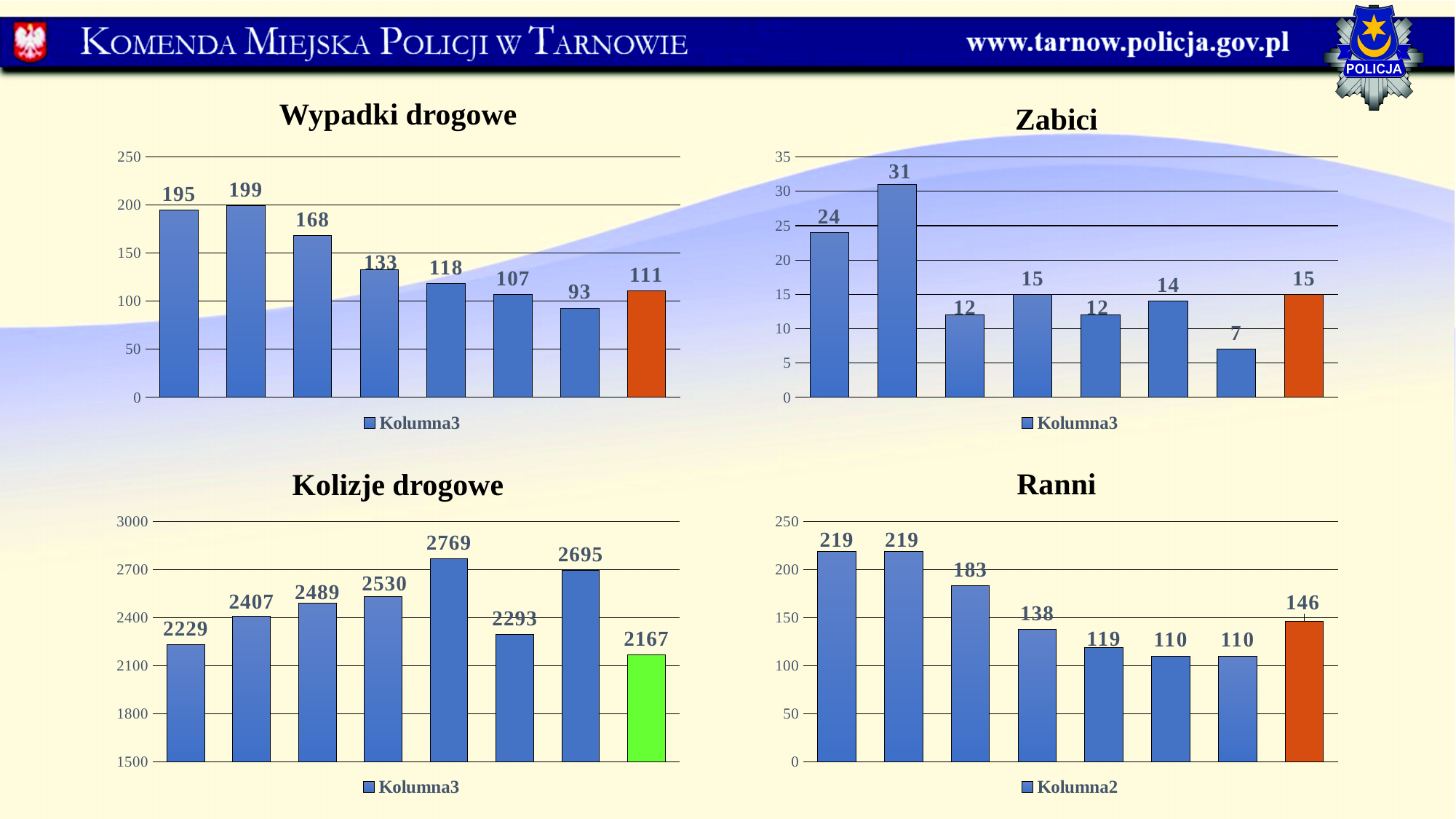
In the "Zabici" chart, what is the value of the highest bar? 31 How many bars are in the "Zabici" chart? 8 How many charts are on the slide? 4 What legend entry is shown under the "Ranni" chart? Kolumna2 In the "Kolizje drogowe" chart, what is the value of the last (green) bar? 2167 In the "Wypadki drogowe" chart, what is the value of the last (orange) bar? 111 In the "Ranni" chart, which is larger: the third bar (183) or the last bar (146)? 183 In the "Wypadki drogowe" chart, what is the value of the highest bar? 199 What type of chart is the "Ranni" chart? bar chart In the "Zabici" chart, what is the value of the lowest bar? 7 In the "Wypadki drogowe" chart, what is the difference between the first bar (195) and the last bar (111)? 84 In the "Kolizje drogowe" chart, what is the value of the highest bar? 2769